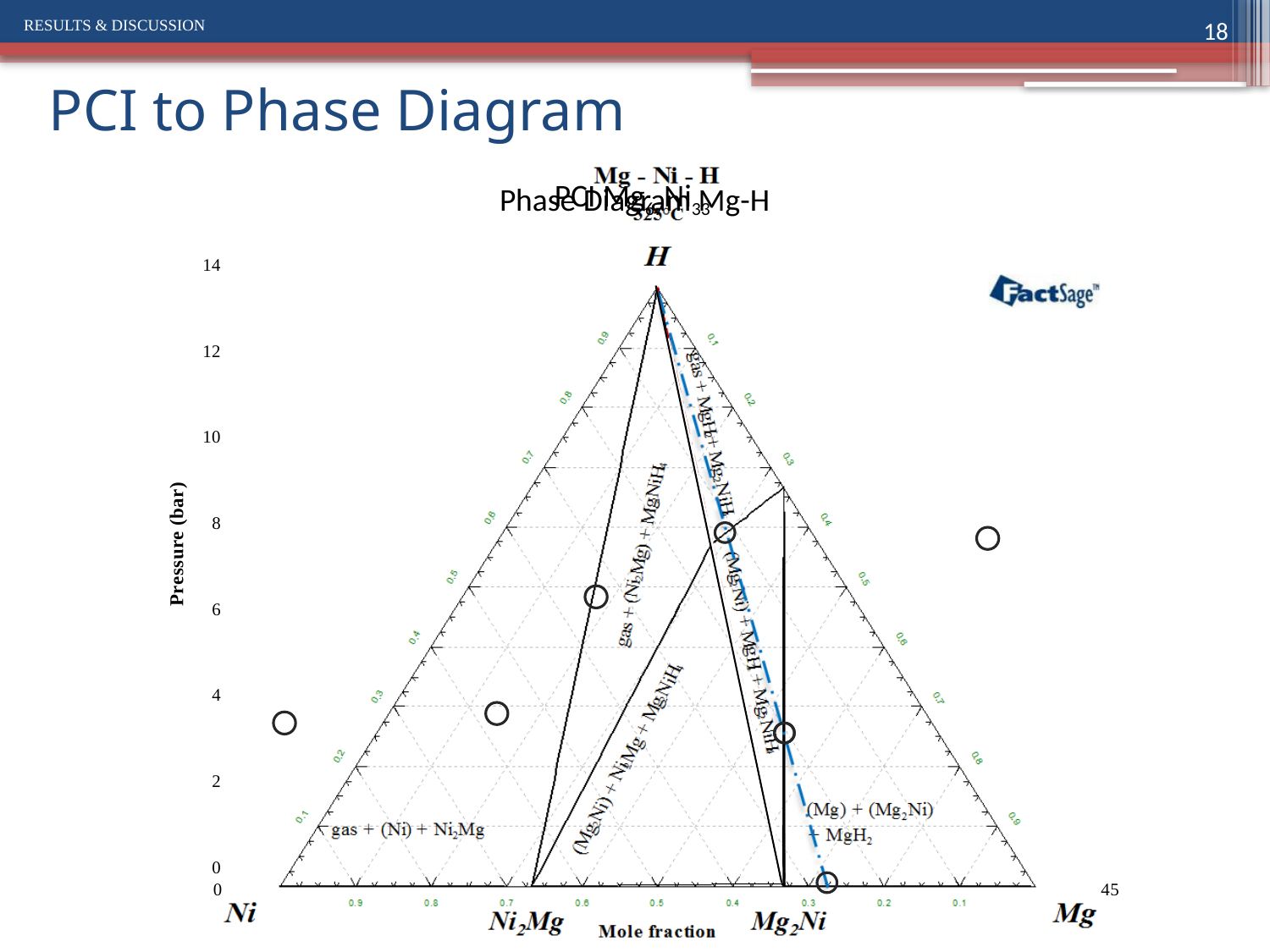
Is the pressure of the highest circular data point greater or less than 6 bar? greater Is the pressure of the rightmost circular data point greater or less than 6 bar? greater What is the highest tick value shown on the vertical axis of the PCI chart? 14 What is the label on the horizontal axis of the ternary phase diagram? Mole fraction What is the label on the vertical axis of the PCI chart? Pressure (bar) Is the pressure of the leftmost circular data point greater or less than 4 bar? less What kind of chart is the PCI plot with circular markers? scatter chart How many circular data points are plotted on the PCI chart? 7